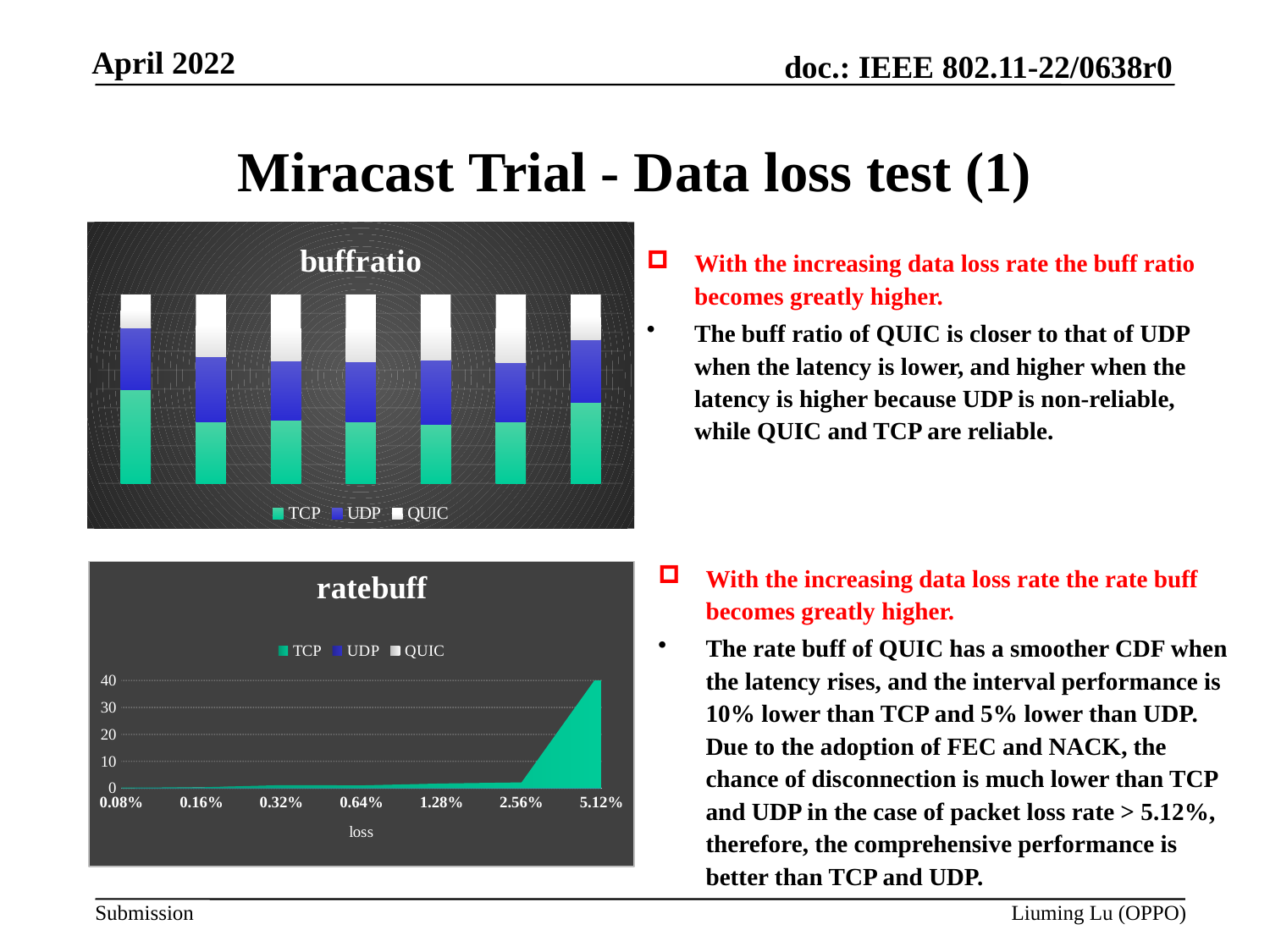
In the 'ratebuff' chart, is the value at 5.12% loss greater or less than 20? greater In the 'buffratio' chart, which series is shown in green? TCP What is the x-axis title of the 'ratebuff' chart? loss In the 'ratebuff' chart, at which loss value is the plotted value highest? 5.12% In the 'buffratio' chart, is the TCP segment of the leftmost bar larger or smaller than the TCP segment of the second bar from the left? larger How many series does the legend of the 'ratebuff' chart list? 3 What kind of chart is the 'buffratio' chart? stacked bar chart How many bars are plotted in the 'buffratio' chart? 7 How many series does the legend of the 'buffratio' chart list? 3 What kind of chart is the 'ratebuff' chart? area chart How many loss categories are shown on the x axis of the 'ratebuff' chart? 7 In the 'ratebuff' chart, is the value at 0.08% loss greater or less than 10? less